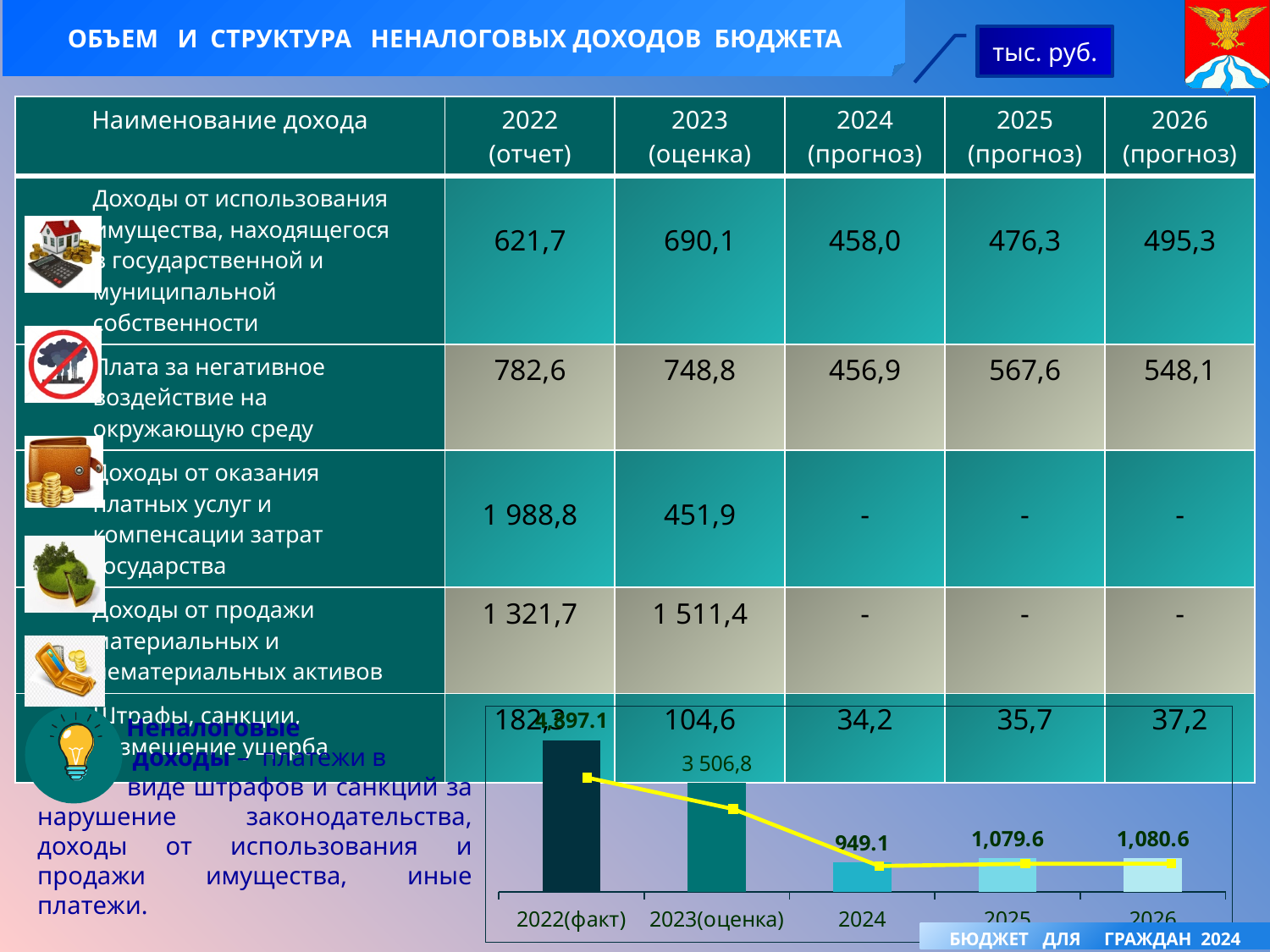
In the chart at the bottom of the slide, do the values rise or fall from 2022(факт) to 2024? Fall In the chart at the bottom of the slide, what is the value for 2025? 1,079.6 How many years (categories) are shown in the chart at the bottom of the slide? 5 What kind of chart is shown at the bottom of the slide? Bar chart with a line overlay In the chart at the bottom of the slide, what is the value for 2026? 1,080.6 In the chart at the bottom of the slide, which is larger: the value for 2023(оценка) or the value for 2024? 2023(оценка) In the chart at the bottom of the slide, what is the difference between the values for 2026 and 2025? 1.0 In the chart at the bottom of the slide, what is the difference between the values for 2025 and 2024? 130.5 In the chart at the bottom of the slide, which year has the lowest value? 2024 In the chart at the bottom of the slide, what is the value for 2023(оценка)? 3 506,8 In the chart at the bottom of the slide, which year has the highest value? 2022(факт) In the chart at the bottom of the slide, what is the value for 2024? 949.1